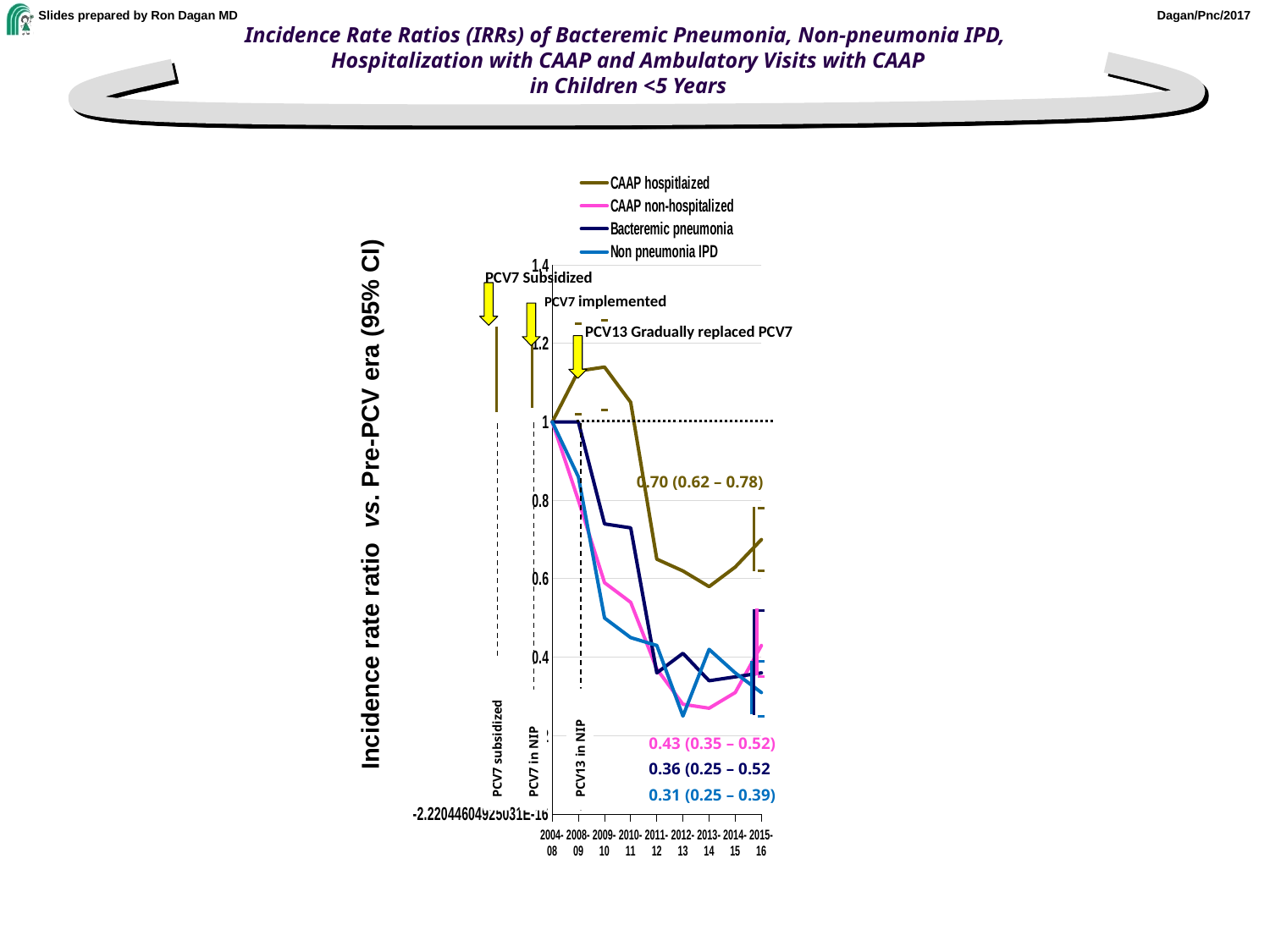
What kind of chart is shown on the slide? Line chart Which series has the lowest incidence rate ratio in 2015-16? Non pneumonia IPD What is the incidence rate ratio for bacteremic pneumonia in 2015-16? 0.36 (0.25 – 0.52) Is the incidence rate ratio for CAAP hospitalized in 2009-10 greater or less than 1? greater How many series does the legend list? 4 Which series has the highest incidence rate ratio in 2015-16? CAAP hospitalized What is the difference between the 2015-16 incidence rate ratios of CAAP hospitalized (0.70) and non pneumonia IPD (0.31)? 0.39 What is the label on the y axis? Incidence rate ratio vs. Pre-PCV era (95% CI) How many time periods are shown along the x axis? 9 What is the incidence rate ratio for CAAP non-hospitalized in 2015-16? 0.43 (0.35 – 0.52) What is the incidence rate ratio for non pneumonia IPD in 2015-16? 0.31 (0.25 – 0.39) What is the incidence rate ratio for CAAP hospitalized in 2015-16? 0.70 (0.62 – 0.78)